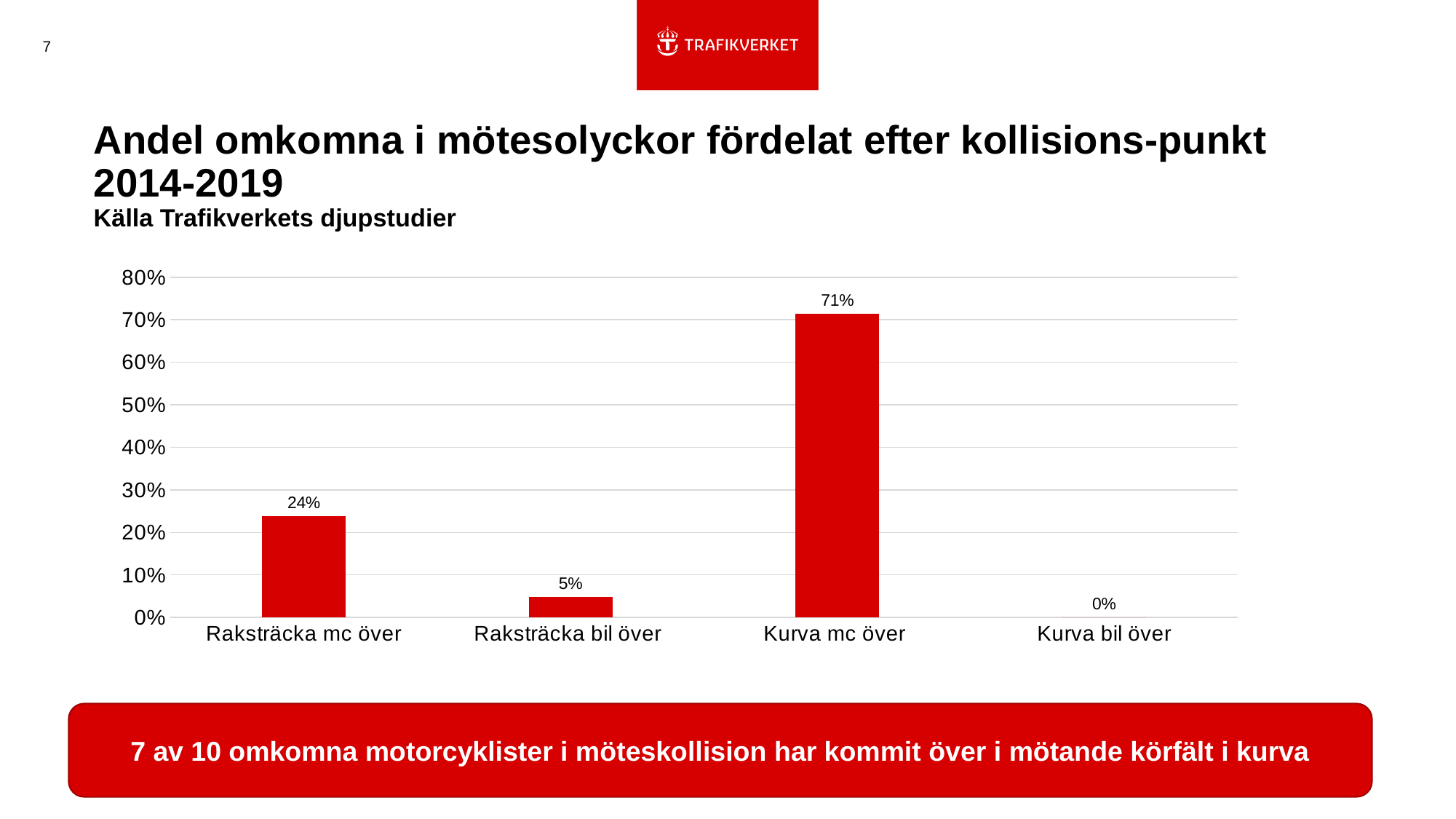
What is the difference between the values for Kurva mc över and Raksträcka mc över? 47% What is the value for Raksträcka mc över? 24% Which category has the highest value? Kurva mc över Which is larger, the value for Raksträcka mc över or Raksträcka bil över? Raksträcka mc över Which category has the lowest value? Kurva bil över What is the value for Raksträcka bil över? 5% What is the value for Kurva mc över? 71% Is the value for Kurva mc över greater or less than 60%? greater How many categories are shown on the x axis? 4 What is the value for Kurva bil över? 0% What is the highest value shown on the y axis? 80% What kind of chart is shown on the slide? bar chart